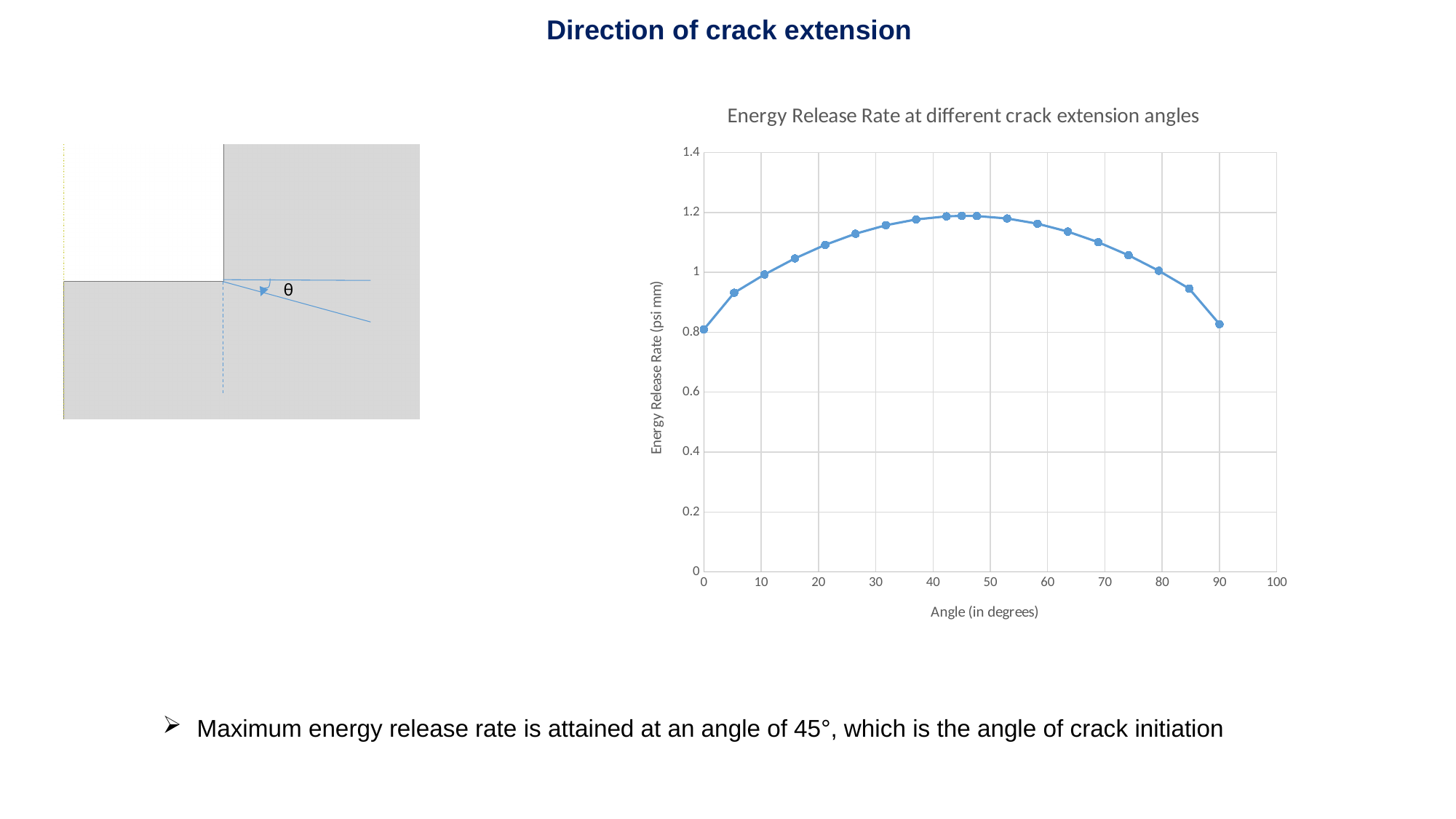
How does the energy release rate change as the angle increases from 0 to 90 degrees? rises to a peak around 45 degrees, then falls Which has the higher energy release rate: the point at about 58 degrees or the point at about 85 degrees? about 58 degrees What type of chart is shown on the slide? line chart Is the energy release rate at an angle of about 5 degrees greater or less than 1? less Is the energy release rate at an angle of about 21 degrees greater or less than 1? greater What is the label of the y axis of the chart? Energy Release Rate (psi mm) What is the title of the chart? Energy Release Rate at different crack extension angles Is the energy release rate at an angle of 45 degrees greater or less than 1? greater At which angle does the energy release rate reach its maximum? 45 Which has the higher energy release rate: the point at about 10 degrees or the point at about 21 degrees? about 21 degrees